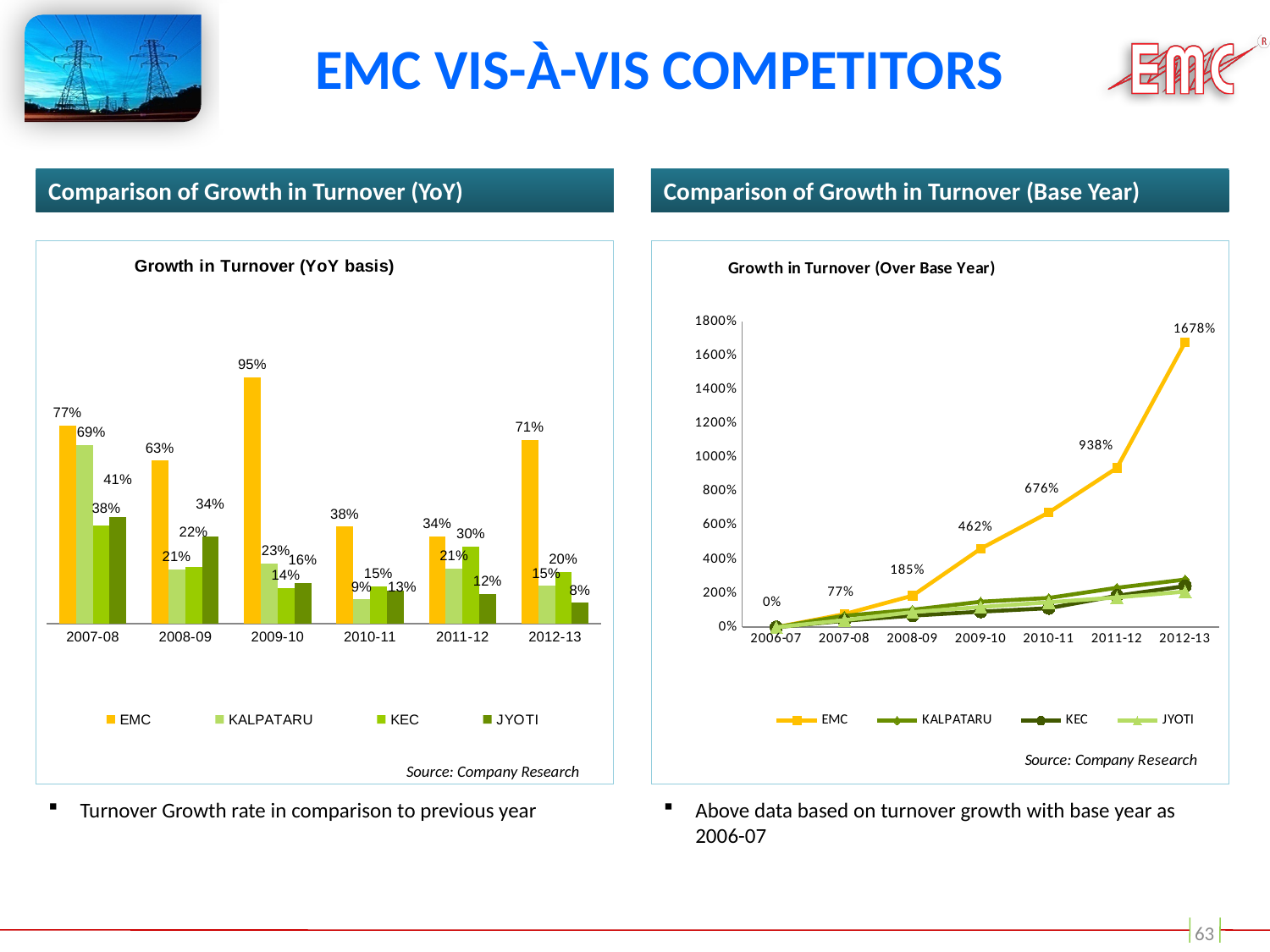
In the 'Growth in Turnover (Over Base Year)' chart, what is the difference between the EMC values for 2011-12 and 2010-11? 262% In the 'Growth in Turnover (Over Base Year)' chart, does the EMC line rise or fall from 2006-07 to 2012-13? Rise In the 'Growth in Turnover (YoY basis)' chart, what is the value for EMC in 2009-10? 95% What kind of chart is the 'Growth in Turnover (YoY basis)' chart? Bar chart How many years are shown on the x axis of the 'Growth in Turnover (YoY basis)' chart? 6 What kind of chart is the 'Growth in Turnover (Over Base Year)' chart? Line chart In the 'Growth in Turnover (YoY basis)' chart, which is larger in 2011-12, KEC or JYOTI? KEC In the 'Growth in Turnover (Over Base Year)' chart, what is the value for EMC in 2012-13? 1678% In the 'Growth in Turnover (YoY basis)' chart, what is the difference between EMC and KALPATARU in 2012-13? 56% In the 'Growth in Turnover (YoY basis)' chart, which year has the highest value for EMC? 2009-10 How many series does the legend of the 'Growth in Turnover (YoY basis)' chart list? 4 In the 'Growth in Turnover (YoY basis)' chart, what is the value for KALPATARU in 2007-08? 69%